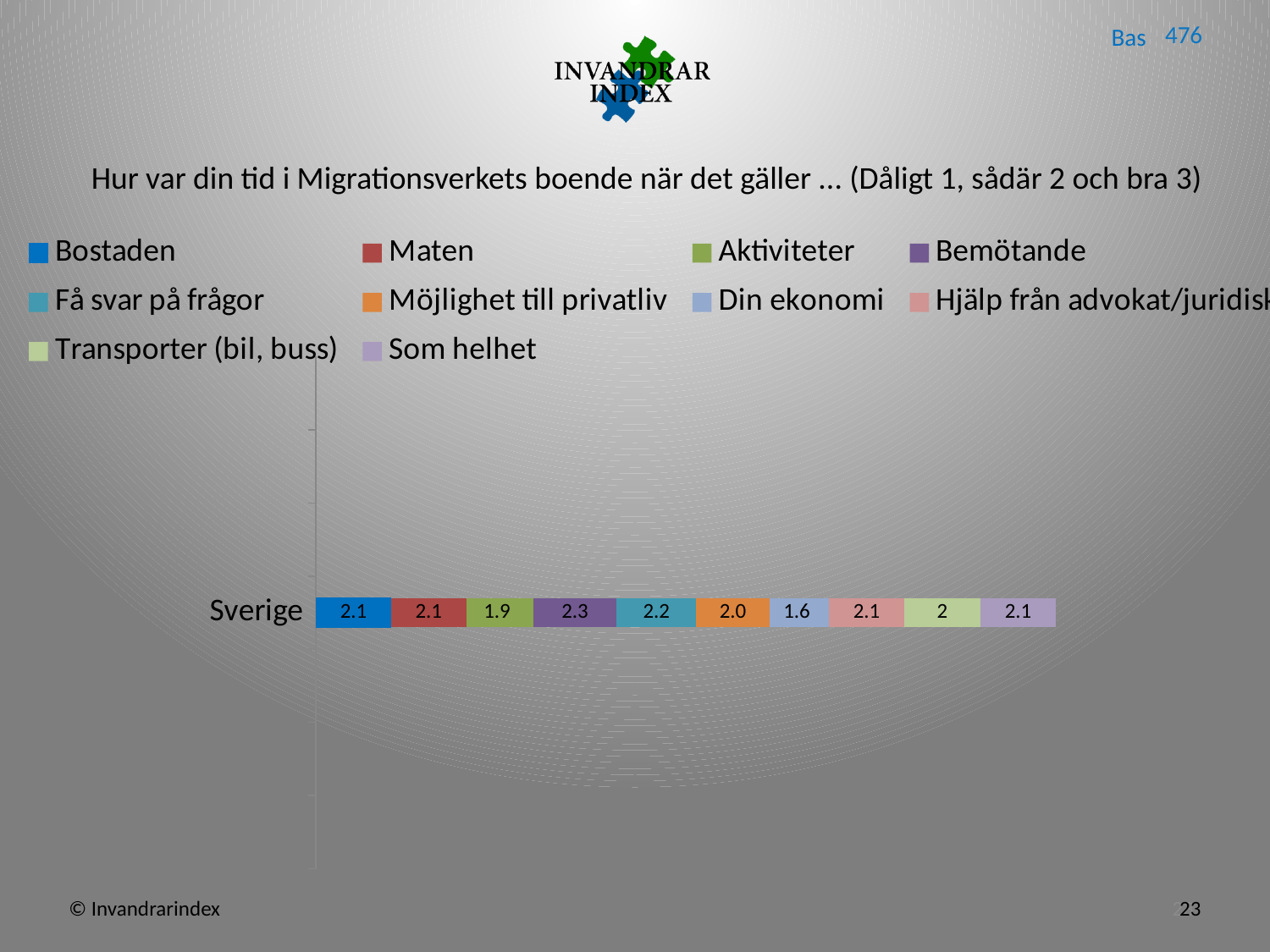
What kind of chart is shown on the slide? bar chart Which series has the highest value for Sverige? Bemötande How many series does the legend list? 10 What is the value for Aktiviteter for Sverige? 1.9 Which is larger for Sverige, Få svar på frågor or Möjlighet till privatliv? Få svar på frågor What is the value for Din ekonomi for Sverige? 1.6 What is the difference between the values for Bemötande and Din ekonomi? 0.7 What is the name of the only category shown on the chart's axis? Sverige What is the value for Bemötande for Sverige? 2.3 What is the value for Få svar på frågor for Sverige? 2.2 Which series has the lowest value for Sverige? Din ekonomi How many categories are plotted on the chart? 1